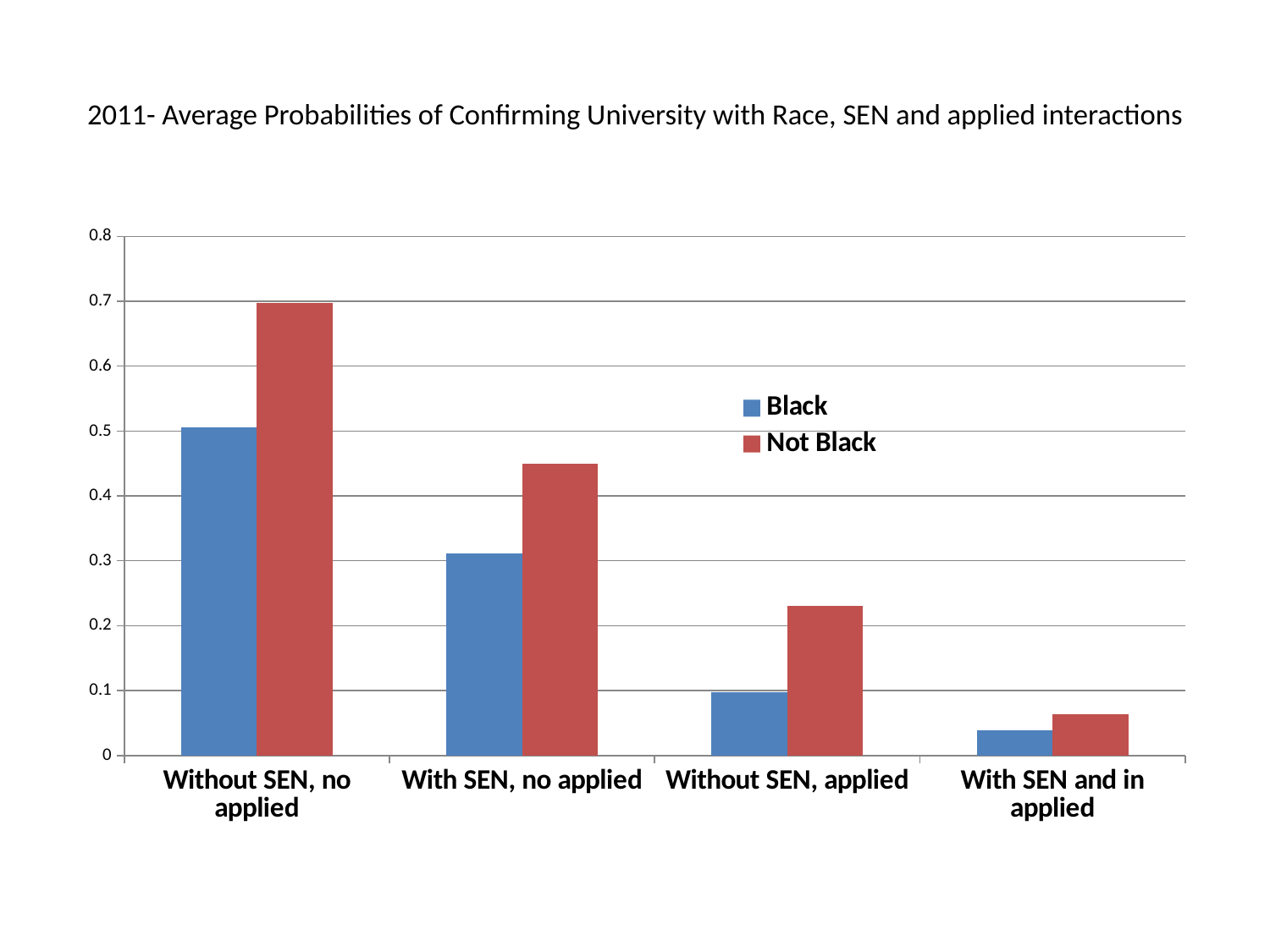
Is the Black value for 'With SEN and in applied' greater or less than 0.1? less Is the Not Black value for 'Without SEN, applied' greater or less than 0.2? greater Which category has the highest value for the Not Black series? Without SEN, no applied How many categories are shown on the x axis? 4 How many series does the legend list? 2 Is the Not Black value for 'With SEN, no applied' greater or less than 0.4? greater Which category has the lowest value for the Black series? With SEN and in applied What colour are the bars for the Not Black series? red What kind of chart is shown on the slide? bar chart Do the values for the Black series rise or fall moving from left to right along the x axis? fall For the category 'With SEN, no applied', which series has the larger value, Black or Not Black? Not Black